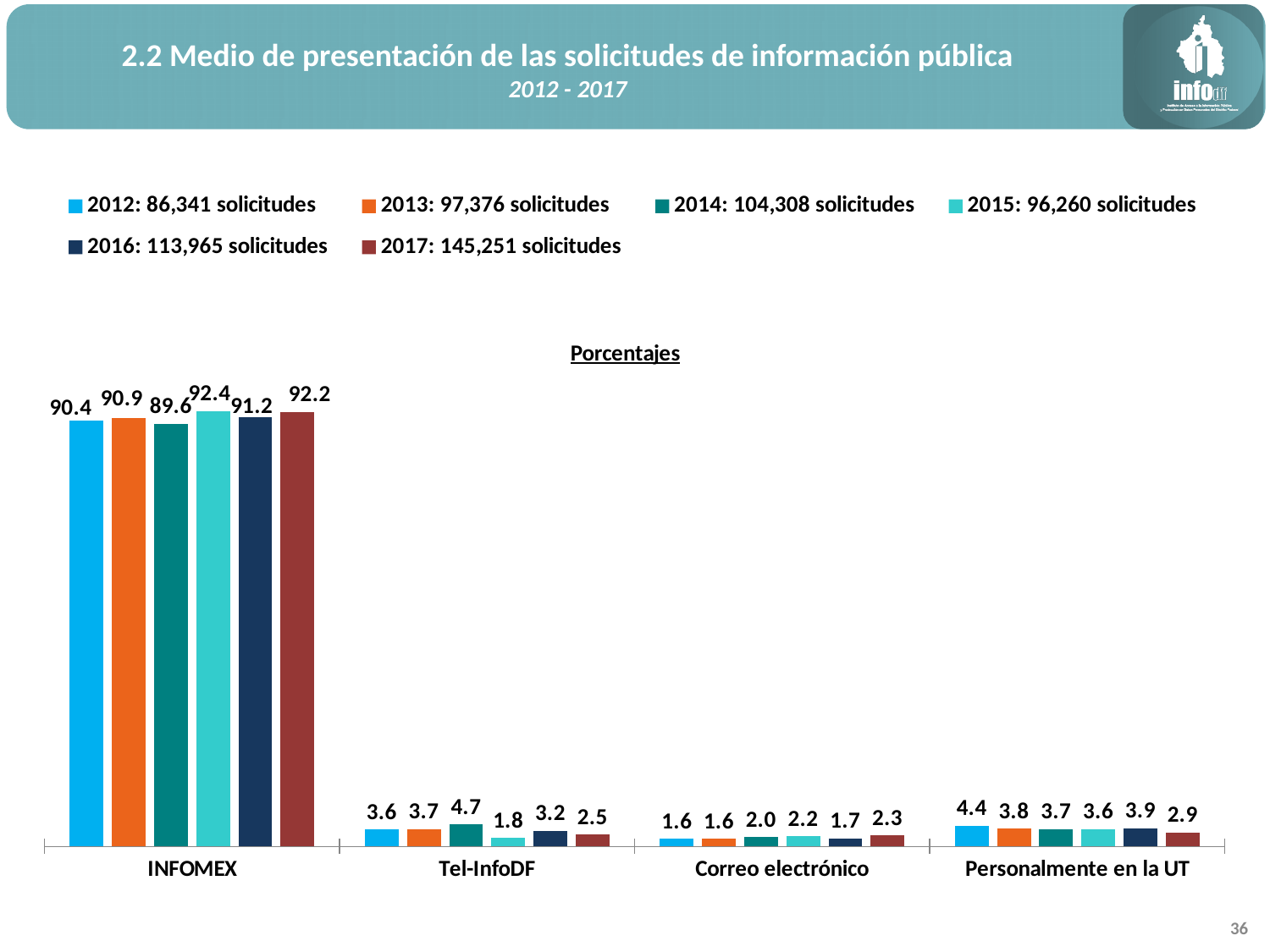
What is the value for INFOMEX in 2015? 92.4 Which year has the highest value for INFOMEX? 2015 What is the value for Tel-InfoDF in 2014? 4.7 What kind of chart is shown on the slide? Bar chart According to the legend, how many solicitudes were there in 2017? 145,251 How many categories are shown on the x axis? 4 How many series does the legend list? 6 Which year has the lowest value for Tel-InfoDF? 2015 What is the difference between the 2017 and 2012 values for INFOMEX? 1.8 Which is larger for Personalmente en la UT: the 2012 value or the 2017 value? 2012 What is the value for Personalmente en la UT in 2012? 4.4 What is the value for Correo electrónico in 2017? 2.3